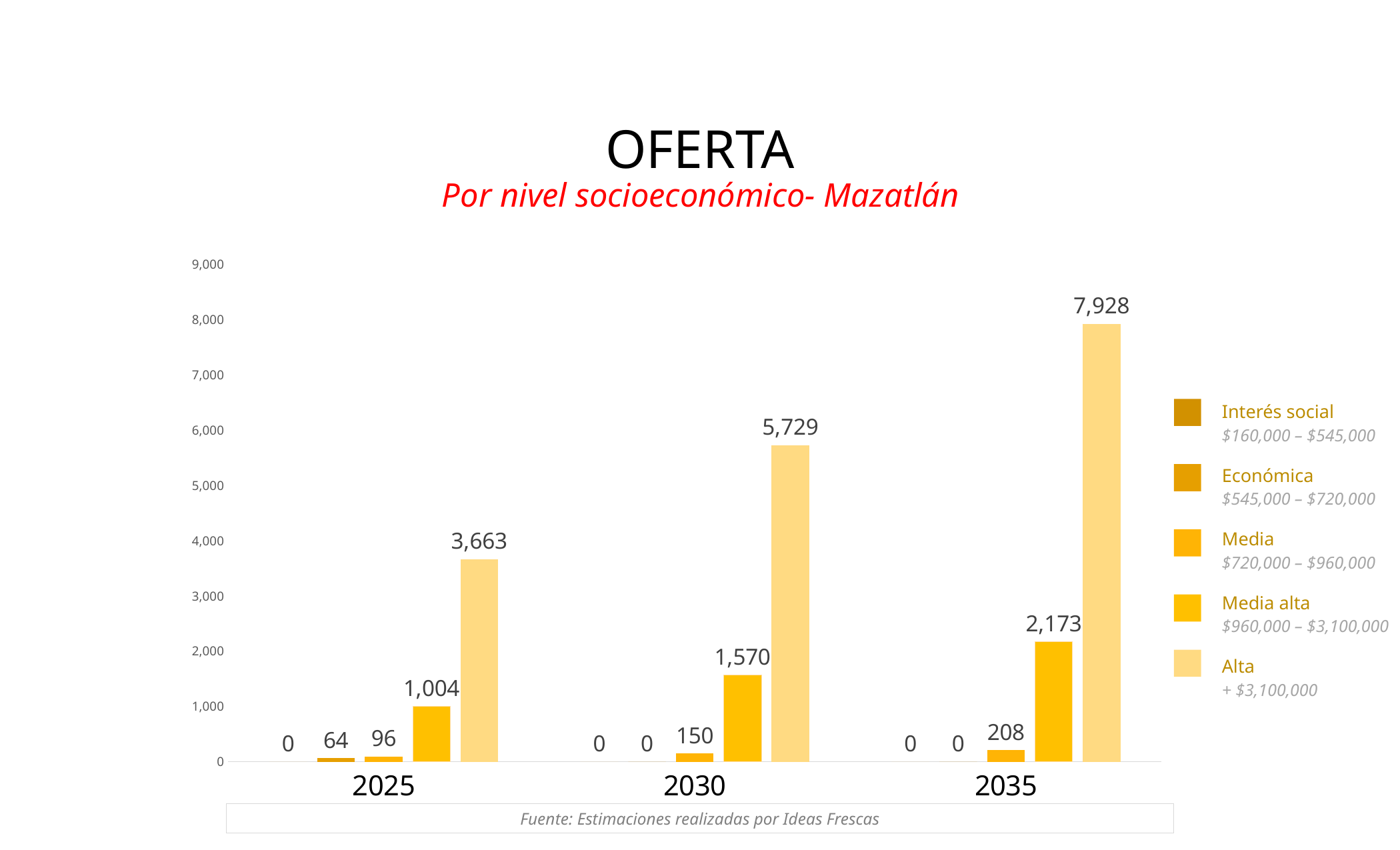
Which year has the highest value for Alta? 2035 Which is larger, Media alta in 2035 or Media alta in 2025? Media alta in 2035 What is the value for Económica in 2025? 64 What is the difference between the Alta values for 2035 and 2030? 2,199 Is the value for Alta in 2030 greater or less than 5,000? greater What is the value for Media in 2035? 208 Which series has the lowest value in 2025? Interés social What is the value for Media alta in 2030? 1,570 How many years are shown on the x axis? 3 How many series does the legend list? 5 What kind of chart is shown on the slide? Bar chart What is the value for Alta in 2035? 7,928